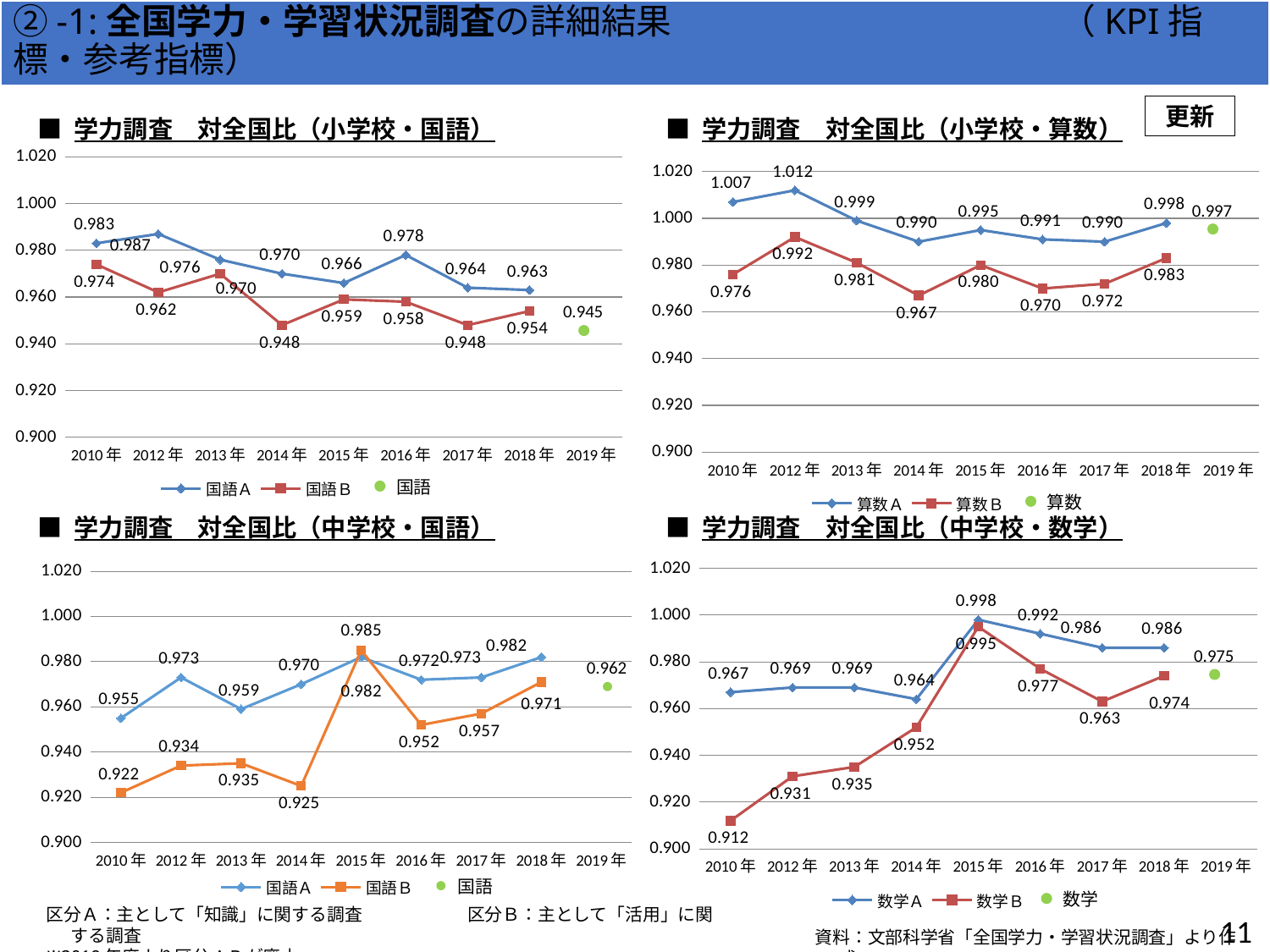
How many entries does the legend of the 中学校・数学 chart (bottom-right) list? 3 In the 小学校・国語 chart (top-left), what is the value of the 国語 point in 2019年? 0.945 In the 中学校・数学 chart (bottom-right), what is the value of 数学B in 2010年? 0.912 In the 小学校・算数 chart (top-right), what is the difference between 算数A and 算数B in 2010年? 0.031 In the 中学校・数学 chart (bottom-right), does 数学B rise or fall from 2010年 to 2015年? rise In the 小学校・国語 chart (top-left), what is the value of 国語A in 2010年? 0.983 In the 小学校・算数 chart (top-right), in which year does 算数A reach its highest value? 2012年 In the 中学校・国語 chart (bottom-left), which is larger in 2015年, 国語A or 国語B? 国語B In the 中学校・国語 chart (bottom-left), what is the value of 国語B in 2015年? 0.985 In the 小学校・算数 chart (top-right), in which year is 算数B lowest? 2014年 What type of chart is the 小学校・国語 chart (top-left)? line chart In the 中学校・数学 chart (bottom-right), what is the difference between 数学A and 数学B in 2017年? 0.023